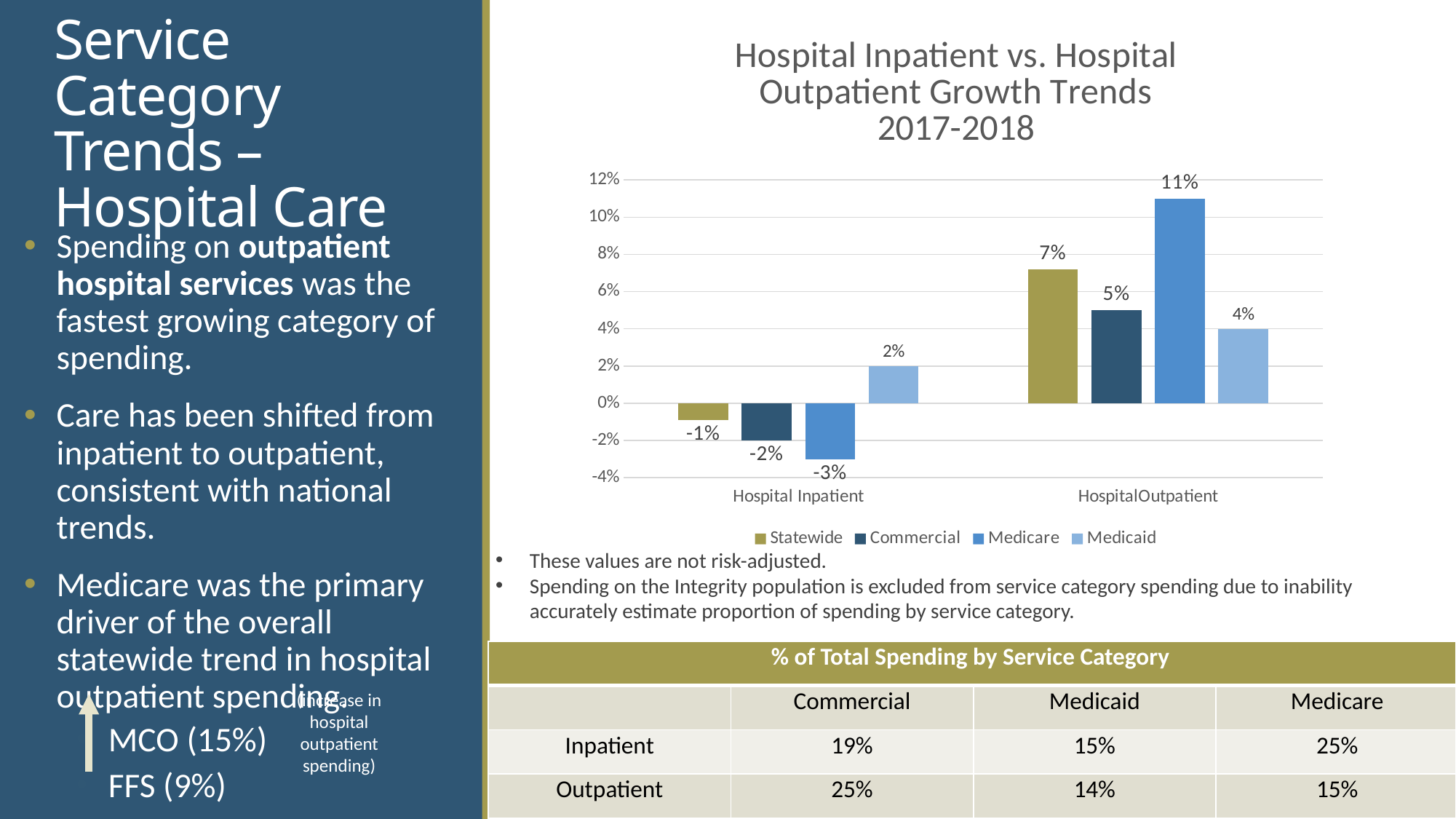
What is the Medicare value for Hospital Outpatient? 11% Which series has the highest value for Hospital Outpatient? Medicare How many categories are shown on the x axis? 2 What is the Statewide value for Hospital Inpatient? -1% Which series has the lowest value for Hospital Inpatient? Medicare Which is larger, the Statewide value for Hospital Outpatient or the Medicaid value for Hospital Outpatient? Statewide What kind of chart is shown on the slide? Bar chart What is the title of the chart? Hospital Inpatient vs. Hospital Outpatient Growth Trends 2017-2018 What is the Commercial value for Hospital Outpatient? 5% What is the Medicaid value for Hospital Inpatient? 2% How many series does the legend list? 4 What is the difference between the Medicare values for Hospital Outpatient and Hospital Inpatient? 14 percentage points